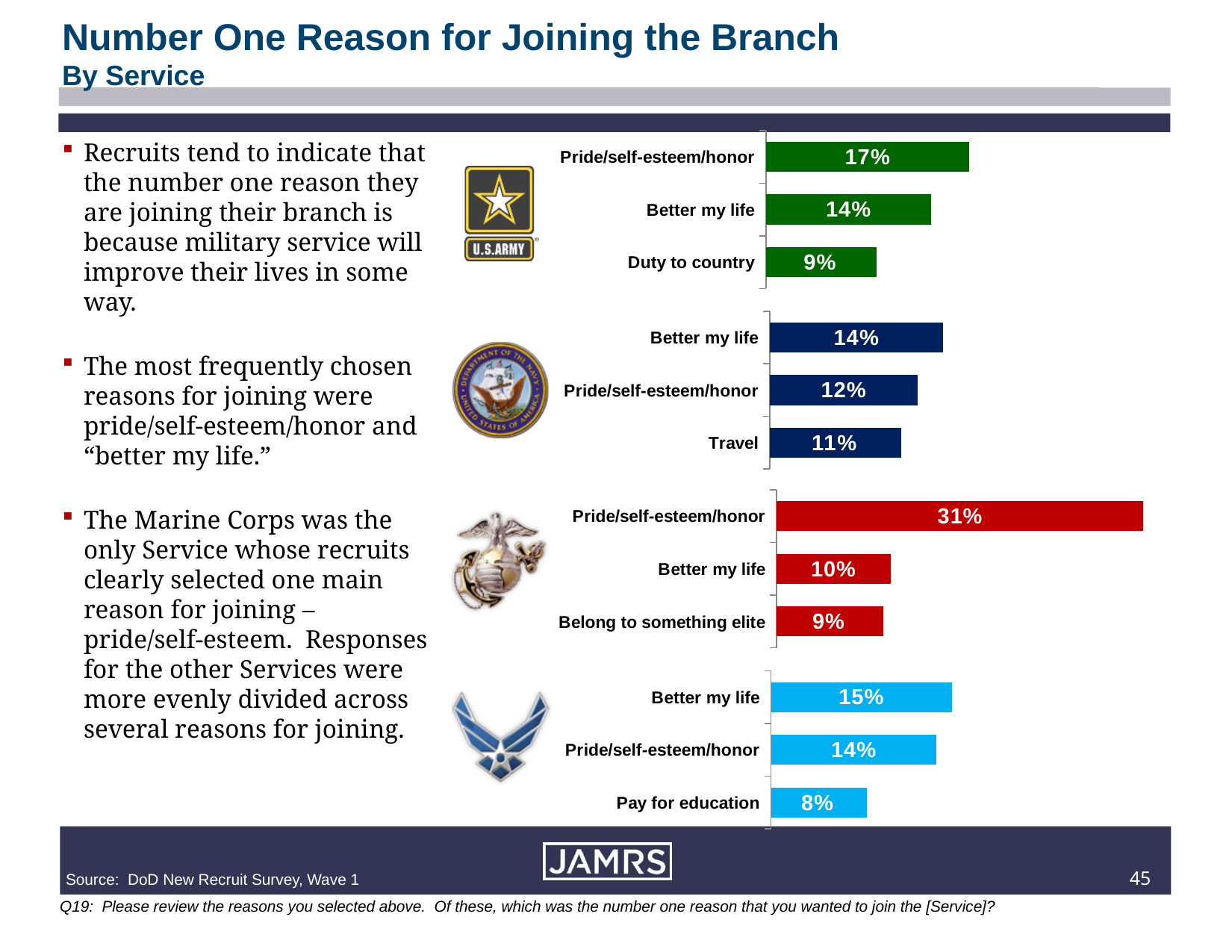
In the third chart from the top (Marine Corps), what percentage is shown for Belong to something elite? 9% In the second chart from the top (Navy), what percentage is shown for Travel? 11% In the bottom chart (Air Force), what is the difference between Better my life and Pay for education? 7% In the third chart from the top (Marine Corps), what is the difference between Pride/self-esteem/honor and Better my life? 21% What colour are the bars in the third chart from the top (Marine Corps)? Red In the top chart (U.S. Army), what percentage is shown for Duty to country? 9% What type of chart is used to show the reasons for joining each service? Bar chart In the third chart from the top (Marine Corps), which reason has the highest value? Pride/self-esteem/honor In the top chart (U.S. Army), what percentage is shown for Pride/self-esteem/honor? 17% In the bottom chart (Air Force), which reason has the lowest value? Pay for education In the second chart from the top (Navy), which is larger: Better my life or Pride/self-esteem/honor? Better my life How many reasons are plotted in the top chart (U.S. Army)? 3